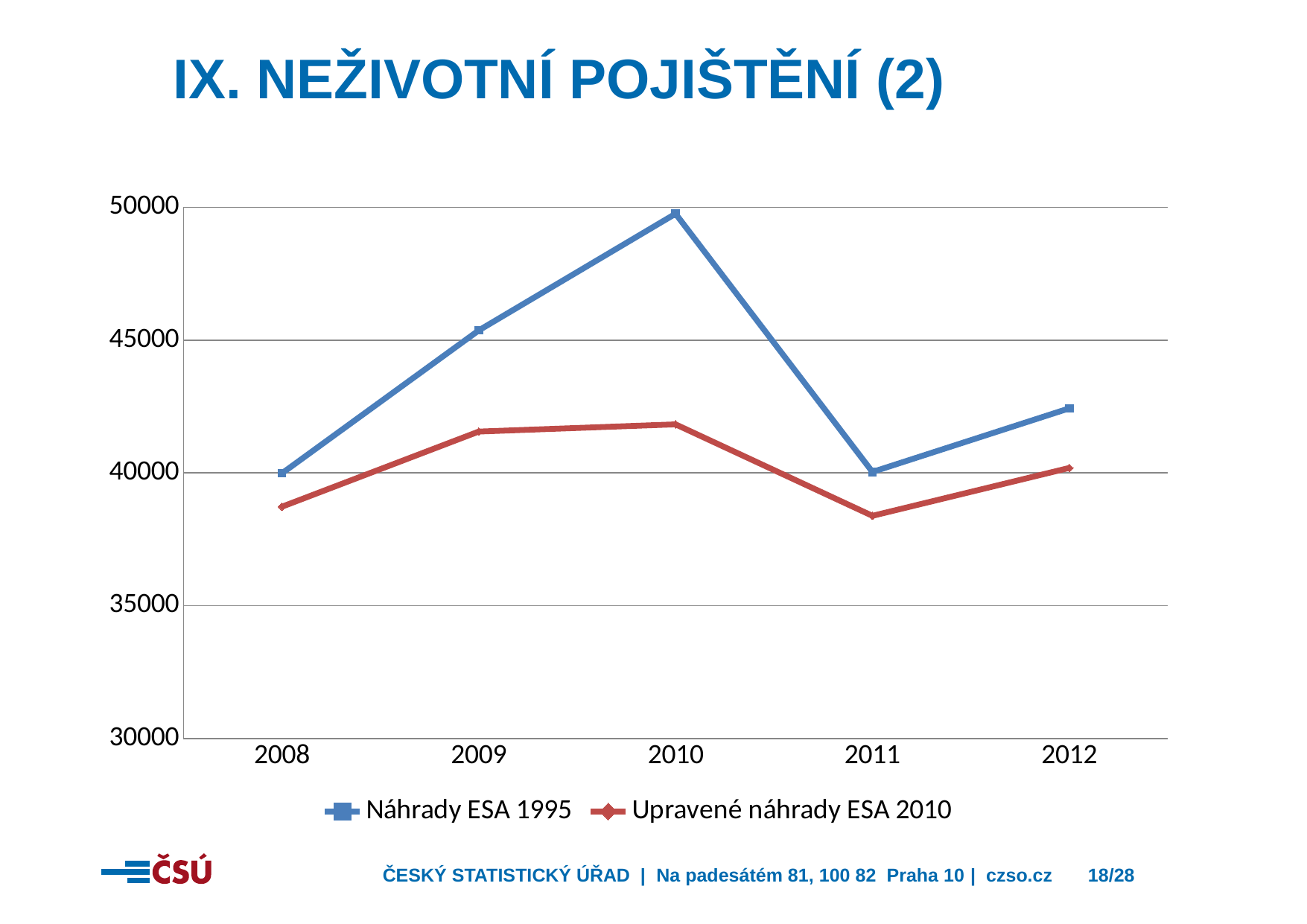
Which series has the higher value in 2010, Náhrady ESA 1995 or Upravené náhrady ESA 2010? Náhrady ESA 1995 Does the value for Náhrady ESA 1995 rise or fall from 2010 to 2011? fall Is the value for Upravené náhrady ESA 2010 in 2008 greater or less than 40000? less What colour is the line for Upravené náhrady ESA 2010? red Is the value for Náhrady ESA 1995 in 2009 greater or less than 45000? greater In which year is the value for Upravené náhrady ESA 2010 lowest? 2011 How many years are shown on the x axis? 5 What kind of chart is shown on the slide? line chart How many series does the legend list? 2 In which year is the value for Upravené náhrady ESA 2010 highest? 2010 Is the value for Náhrady ESA 1995 in 2010 greater or less than 45000? greater In which year is the value for Náhrady ESA 1995 highest? 2010